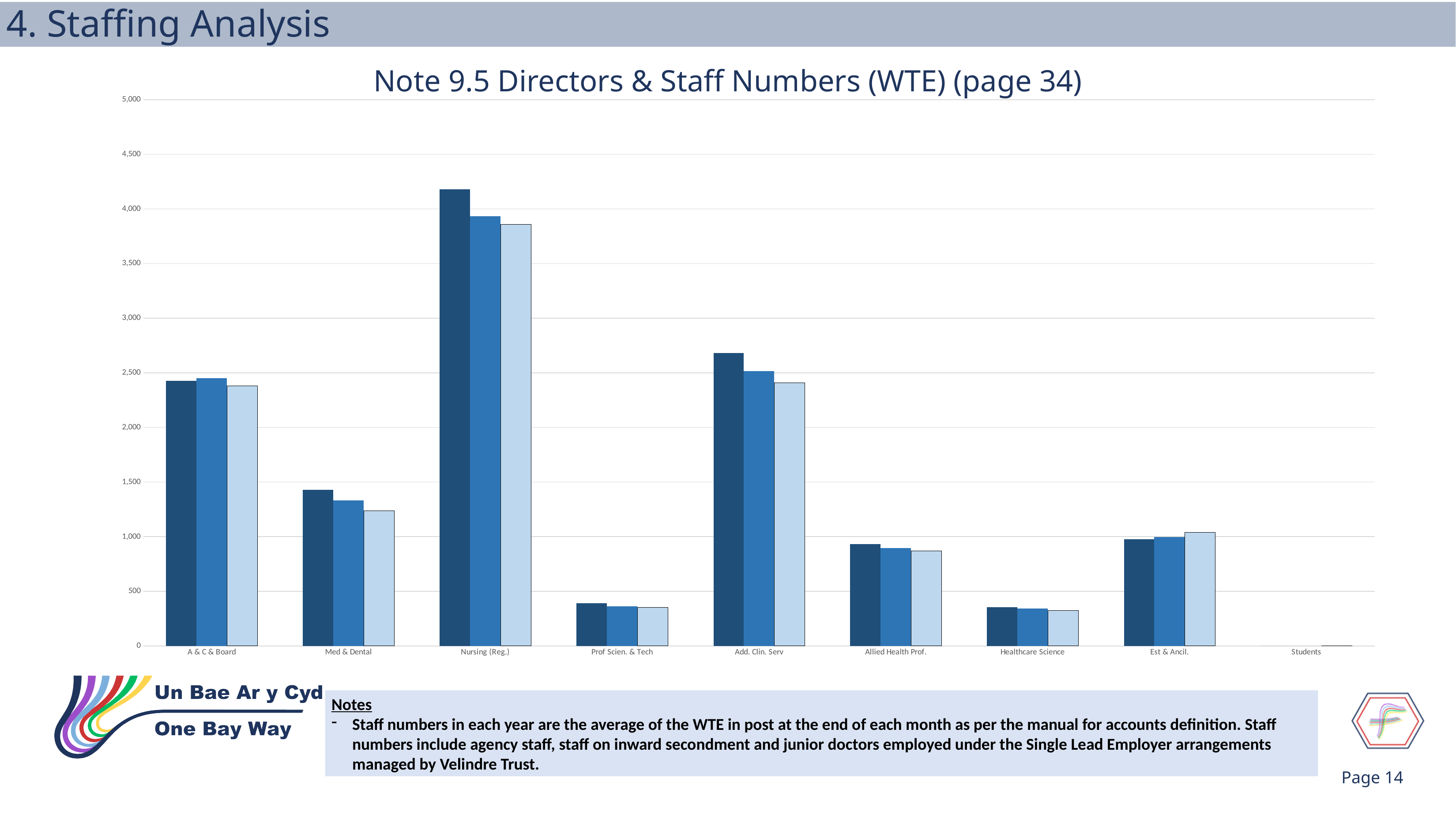
What is the title of the chart? Note 9.5 Directors & Staff Numbers (WTE) (page 34) Is the value of the tallest bar for Med & Dental greater or less than 1,500? less How many staff categories are shown along the x axis? 9 Which category has larger bars, Nursing (Reg.) or Add. Clin. Serv? Nursing (Reg.) Which staff category has the highest bars? Nursing (Reg.) Is the value of the tallest bar for Nursing (Reg.) greater or less than 4,000? greater Within the Nursing (Reg.) category, do the three bars rise or fall from left to right? fall Which staff category has the lowest bars? Students Are the bars for Allied Health Prof. greater or less than 1,000? less What kind of chart is shown on the slide? bar chart